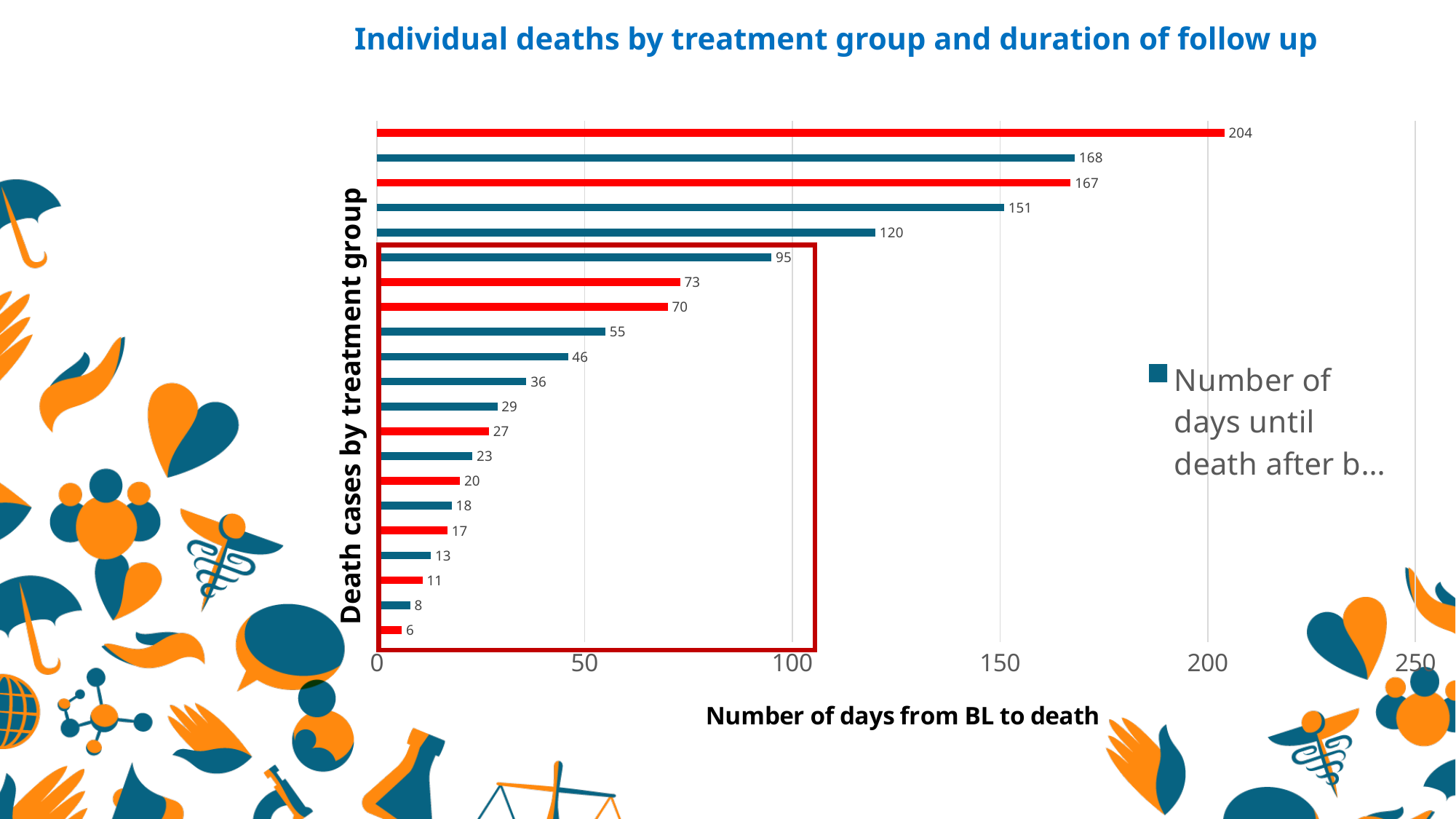
How many bars have a value greater than 100? 5 What is the highest number of days from BL to death shown in the chart? 204 How many red bars are there in the chart? 9 What kind of chart is shown on the slide? bar chart What is the lowest number of days from BL to death shown in the chart? 6 What is the label of the horizontal axis? Number of days from BL to death Which is larger: the longest red bar or the longest blue bar? the longest red bar (204) How many series does the legend list? 1 What is the difference between the two longest bars, 204 and 168? 36 What is the difference between the longest bar (204) and the shortest bar (6)? 198 What is the title of the chart? Individual deaths by treatment group and duration of follow up How many bars (death cases) are plotted in the chart? 21